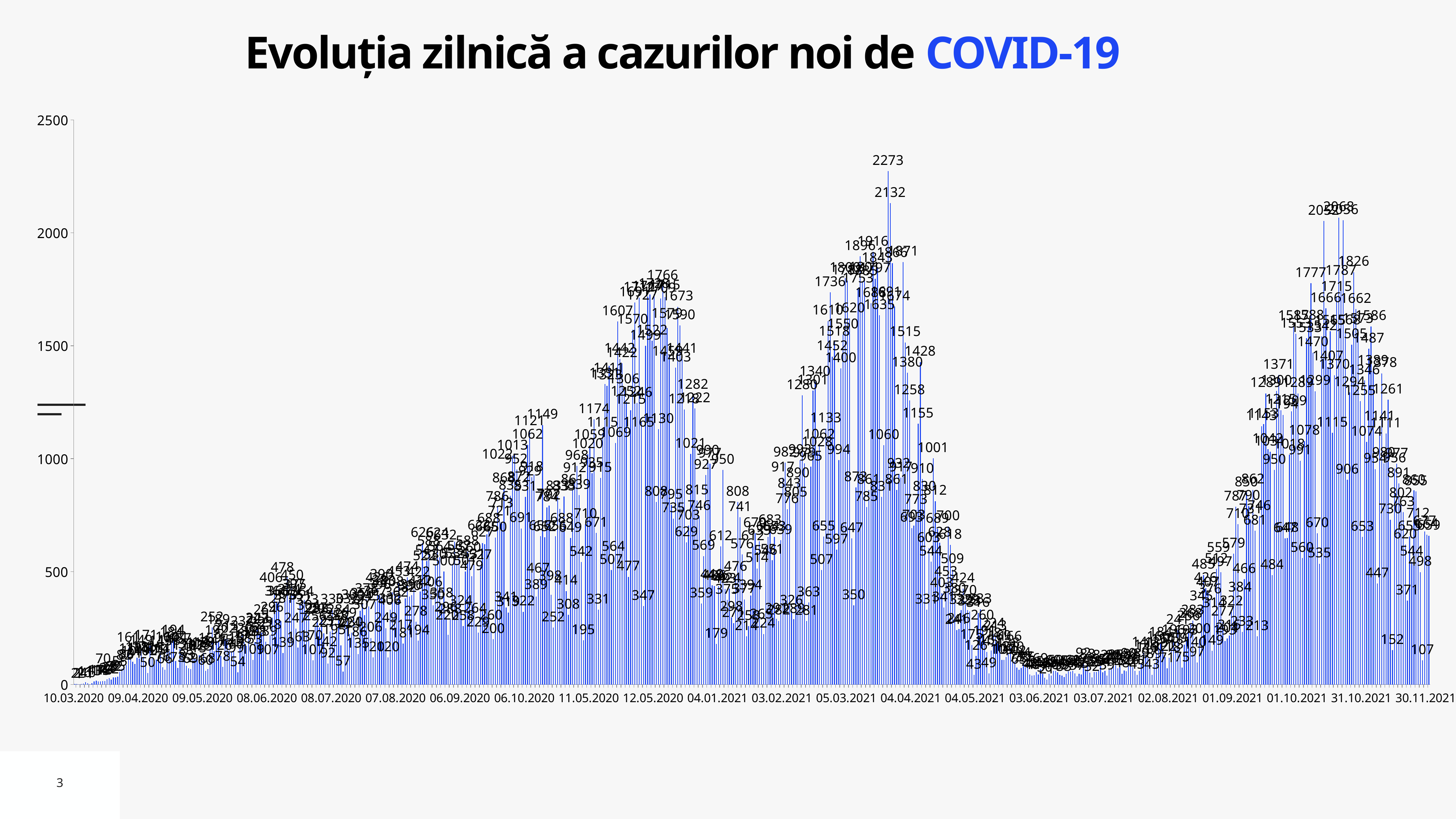
What is the second-highest value labelled on the chart, just below the 2273 peak? 2132 Are the values around 03.07.2021 greater or less than 500? less Which is larger: the peak around 04.04.2021 or the peak around 12.05.2020? the peak around 04.04.2021 Do the values rise or fall between 04.04.2021 and 04.05.2021? fall What is the highest daily value labelled on the chart? 2273 What is the first date label on the horizontal axis? 10.03.2020 Do the values rise or fall between 01.09.2021 and 01.10.2021? rise What is the title of the chart? Evoluția zilnică a cazurilor noi de COVID-19 What is the maximum value shown on the vertical axis? 2500 What is the difference between the two highest labelled values, 2273 and 2132? 141 What kind of chart is shown on the slide? bar chart Is the highest value on the chart greater or less than 2000? greater